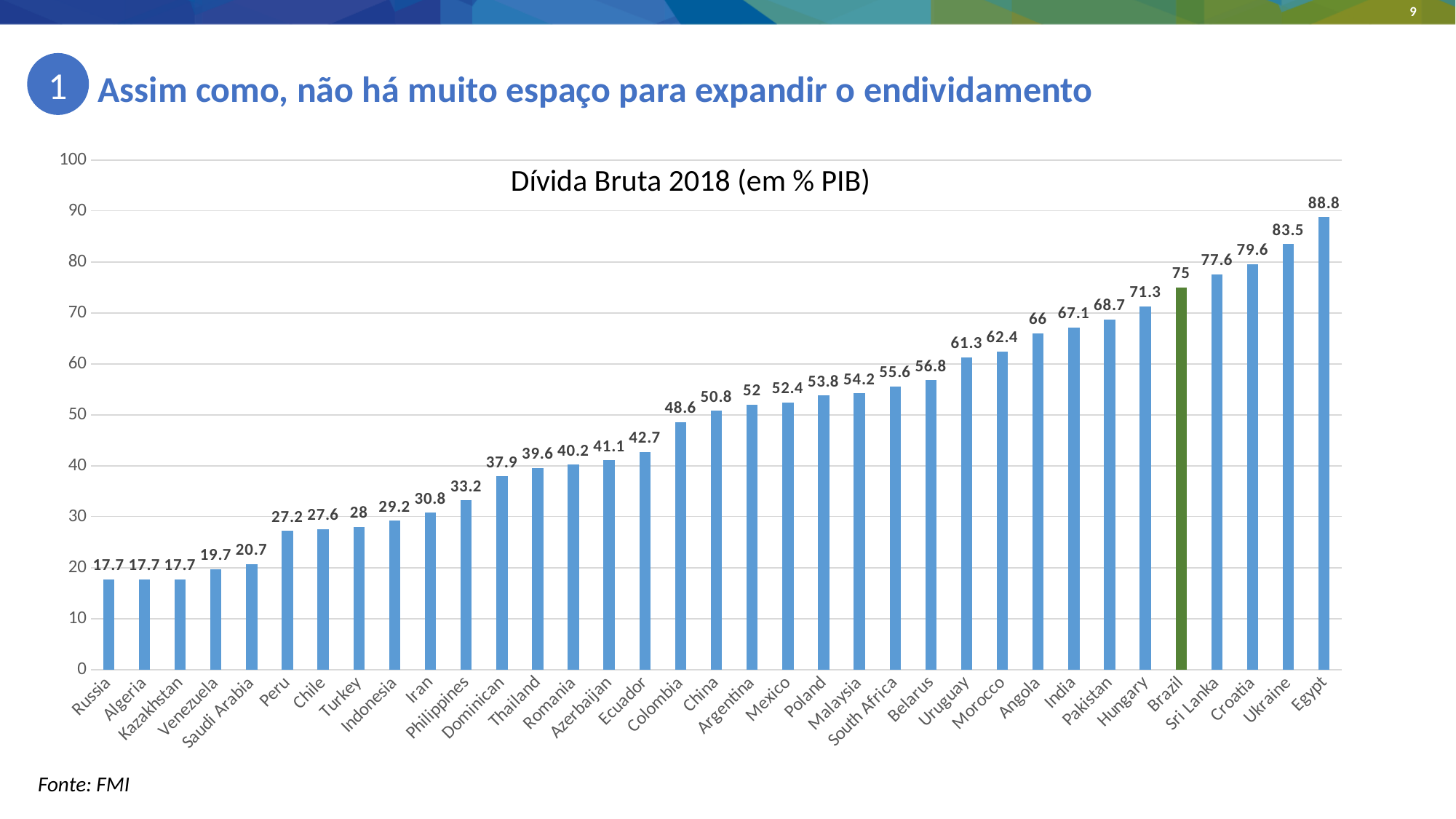
What is the difference between the values for Egypt and Brazil? 13.8 Is the value for Colombia greater or less than 50? less How many countries are shown in the chart? 35 What kind of chart is this? bar chart What is the title of the chart? Dívida Bruta 2018 (em % PIB) Which country has the highest value? Egypt What is the value for Mexico? 52.4 What is the value for Brazil? 75 Which is larger, the value for India or the value for Angola? India Which country's bar is coloured green instead of blue? Brazil What is the value for Egypt? 88.8 Do the values rise or fall from left to right along the x axis? rise